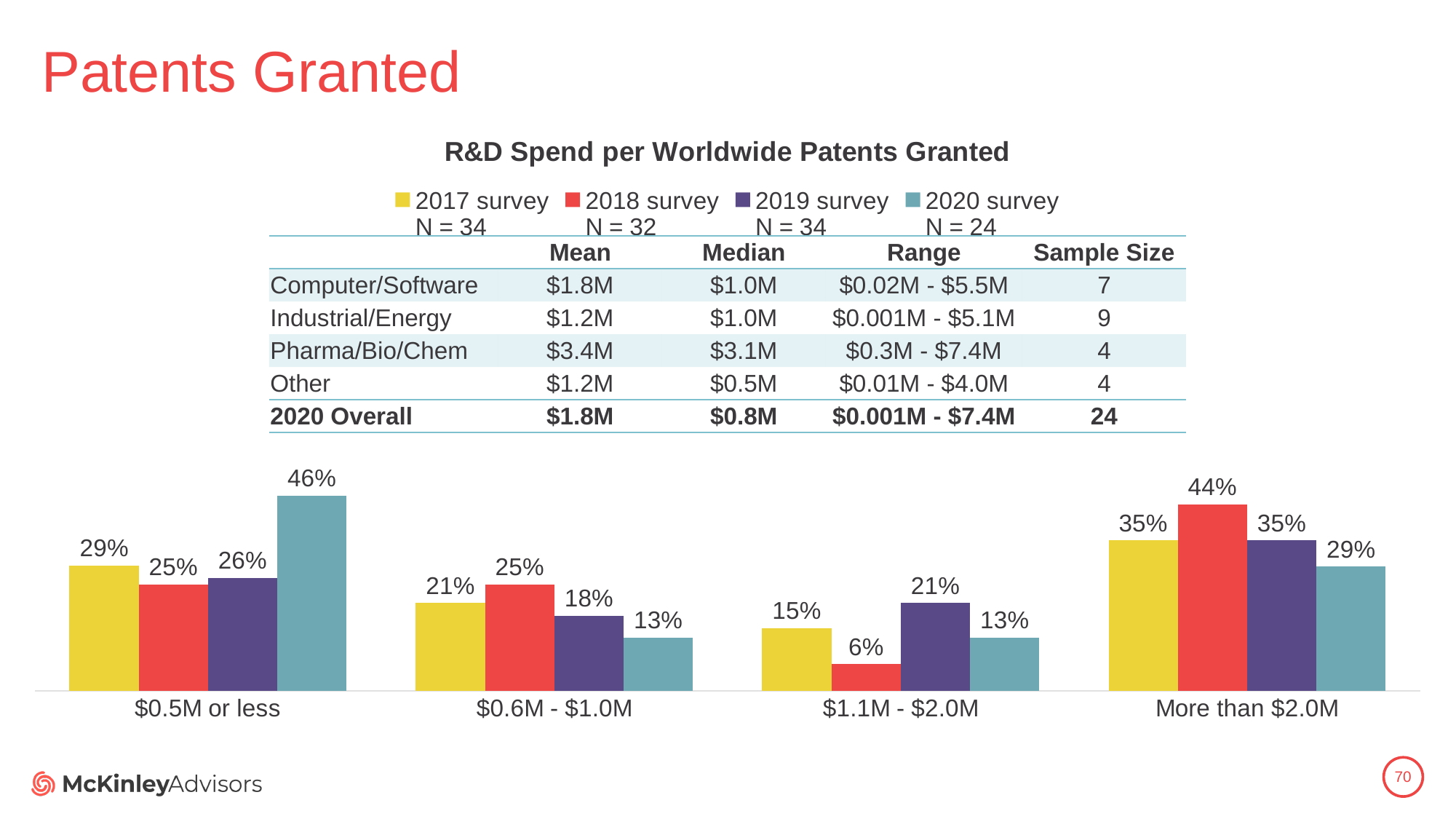
Which is larger in the "More than $2.0M" category: the 2018 survey or the 2020 survey? 2018 survey Which category has the highest value for the 2018 survey? More than $2.0M Which category has the lowest value for the 2017 survey? $1.1M - $2.0M What is the value for the 2019 survey in the "$0.6M - $1.0M" category? 18% What is the difference between the 2020 survey and 2017 survey values in the "$0.5M or less" category? 17% What sample size (N) does the legend give for the 2020 survey? N = 24 How many series does the legend list? 4 What kind of chart is shown on the slide? bar chart How many categories are shown on the x axis? 4 What is the chart's title? R&D Spend per Worldwide Patents Granted What is the value for the 2018 survey in the "$1.1M - $2.0M" category? 6% What is the value for the 2020 survey in the "$0.5M or less" category? 46%